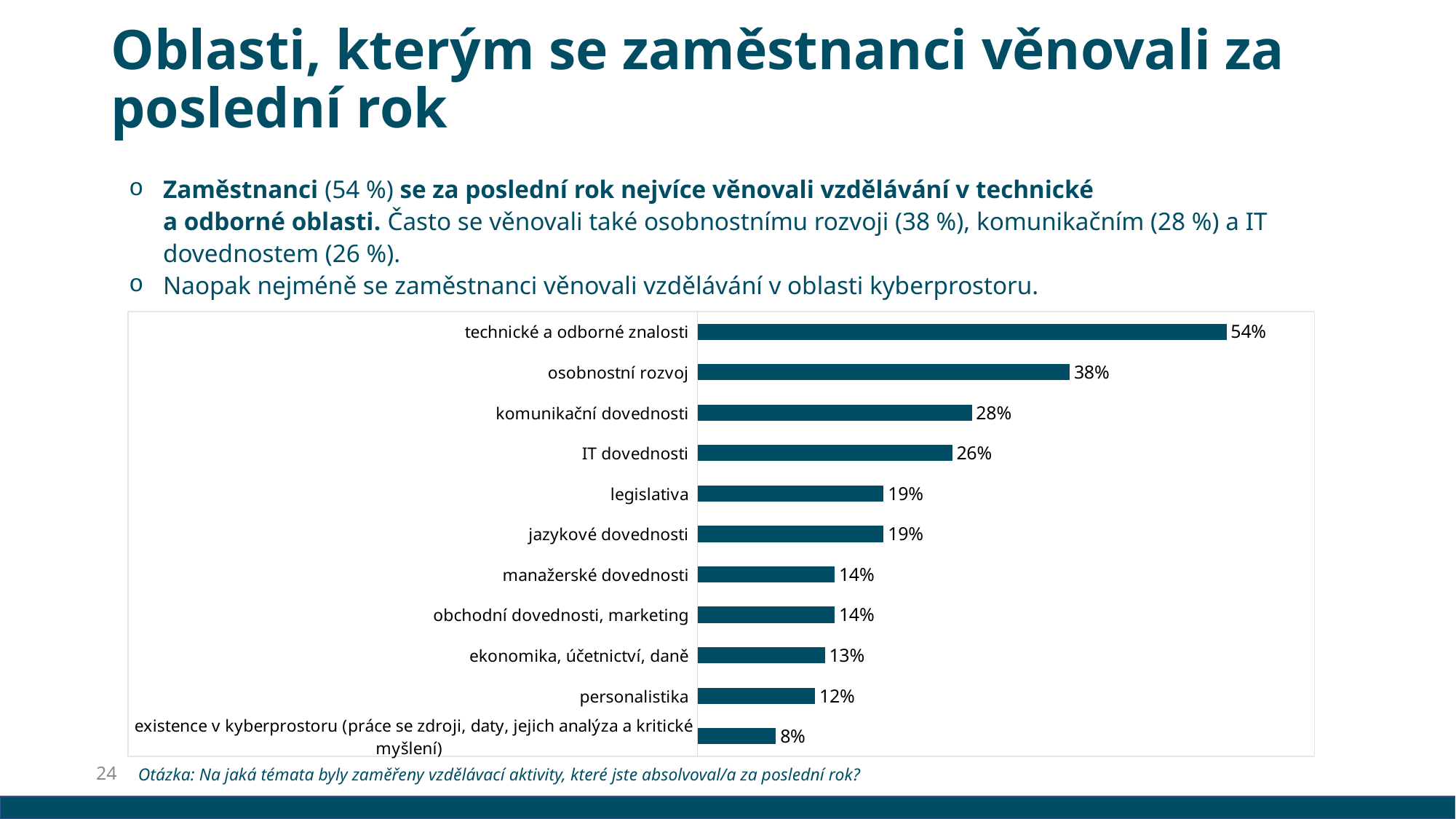
Which category has the highest value? technické a odborné znalosti Which category has the lowest value? existence v kyberprostoru (práce se zdroji, daty, jejich analýza a kritické myšlení) What value is shown for both legislativa and jazykové dovednosti? 19% What is the value for personalistika? 12% What is the difference between the values for technické a odborné znalosti and osobnostní rozvoj? 16% What is the difference between the values for komunikační dovednosti and IT dovednosti? 2% What is the value for ekonomika, účetnictví, daně? 13% What kind of chart is shown on the slide? bar chart How many categories are shown in the chart? 11 What is the value for technické a odborné znalosti? 54% What is the value for osobnostní rozvoj? 38% Which is larger, the value for legislativa or the value for manažerské dovednosti? legislativa